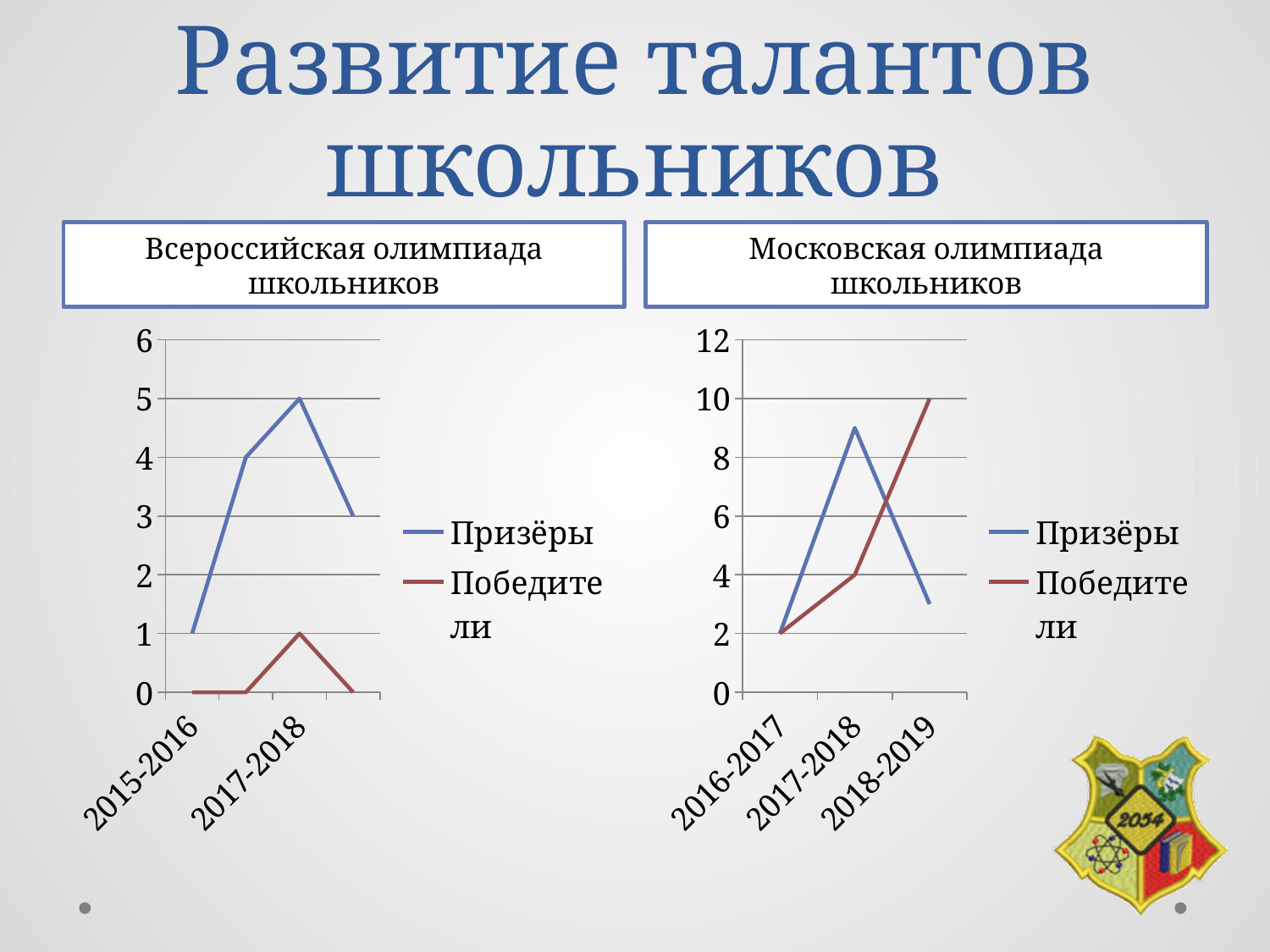
On the right chart 'Московская олимпиада школьников', which series has the larger value in 2018-2019, Призёры or Победители? Победители On the right chart 'Московская олимпиада школьников', what is the value for Призёры in 2016-2017? 2 On the left chart 'Всероссийская олимпиада школьников', what is the value for Призёры in 2017-2018? 5 How many series does the legend of the left chart 'Всероссийская олимпиада школьников' list? 2 On the left chart 'Всероссийская олимпиада школьников', how much higher is the Призёры value in 2017-2018 than in 2015-2016? 4 On the right chart 'Московская олимпиада школьников', what is the value for Победители in 2017-2018? 4 On the left chart 'Всероссийская олимпиада школьников', what is the value for Призёры in 2015-2016? 1 What kind of chart is used on the left chart, 'Всероссийская олимпиада школьников'? line chart On the left chart 'Всероссийская олимпиада школьников', what is the value for Победители in 2017-2018? 1 On the right chart 'Московская олимпиада школьников', how many year categories are shown on the x axis? 3 On the right chart 'Московская олимпиада школьников', is the value for Призёры in 2017-2018 greater or less than 8? greater On the right chart 'Московская олимпиада школьников', what is the value for Победители in 2018-2019? 10